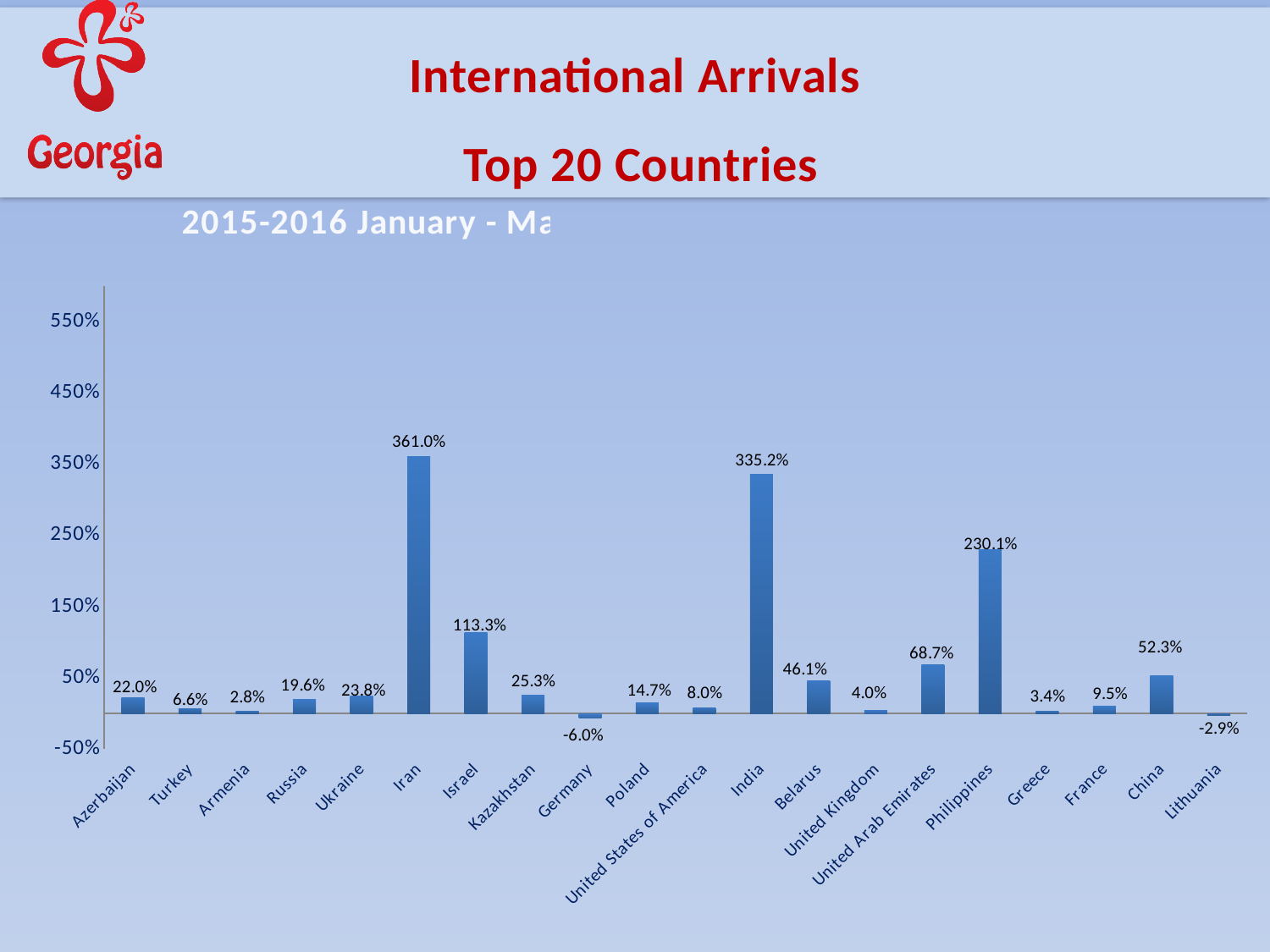
What is the value for Germany? -6.0% What is the value for United Arab Emirates? 68.7% How many countries have a negative value? 2 Which is larger, the value for Philippines or the value for Israel? Philippines What kind of chart is shown on the slide? Bar chart What is the value for Iran? 361.0% What is the difference between the values for Iran and India? 25.8 percentage points Is the value for India greater or less than 250%? greater Which country has the highest value? Iran What is the value for Philippines? 230.1% Which country has the lowest value? Germany How many countries are shown on the chart? 20